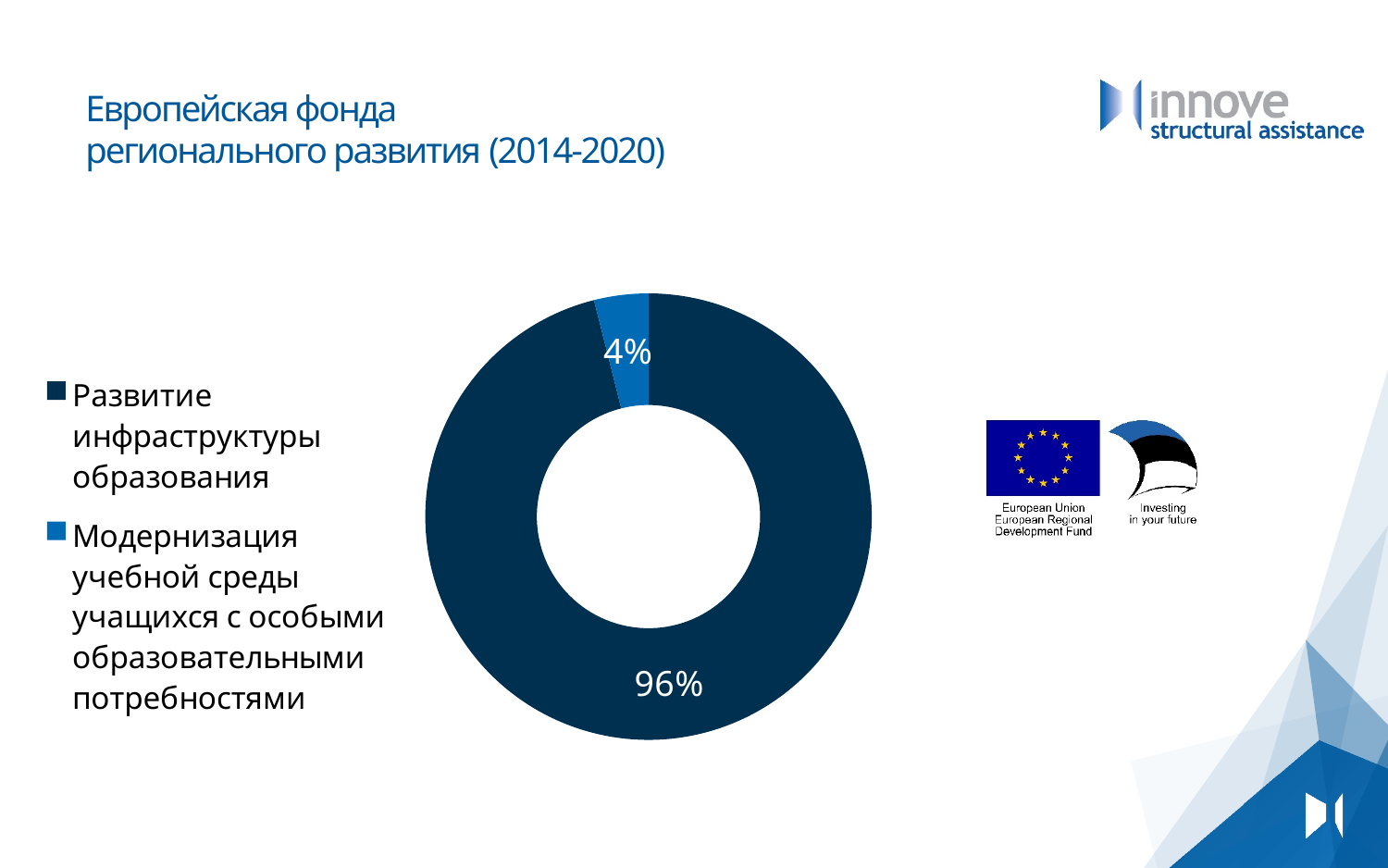
What is the title of the slide containing the chart? Европейская фонда регионального развития (2014-2020) What share of the chart does "Модернизация учебной среды учащихся с особыми образовательными потребностями" take? 4% How many entries does the chart legend list? 2 Which is larger: the share for "Развитие инфраструктуры образования" or the share for "Модернизация учебной среды учащихся с особыми образовательными потребностями"? Развитие инфраструктуры образования What kind of chart is shown on the slide? Doughnut (pie) chart Which category has the largest share in the chart? Развитие инфраструктуры образования What is the difference in percentage points between the two slices of the chart? 92 percentage points What share of the chart does "Развитие инфраструктуры образования" take? 96% How many slices does the chart have? 2 What colour is the slice for "Развитие инфраструктуры образования"? Dark navy blue What is the total of the two percentages shown on the chart? 100% Which category has the smallest share in the chart? Модернизация учебной среды учащихся с особыми образовательными потребностями